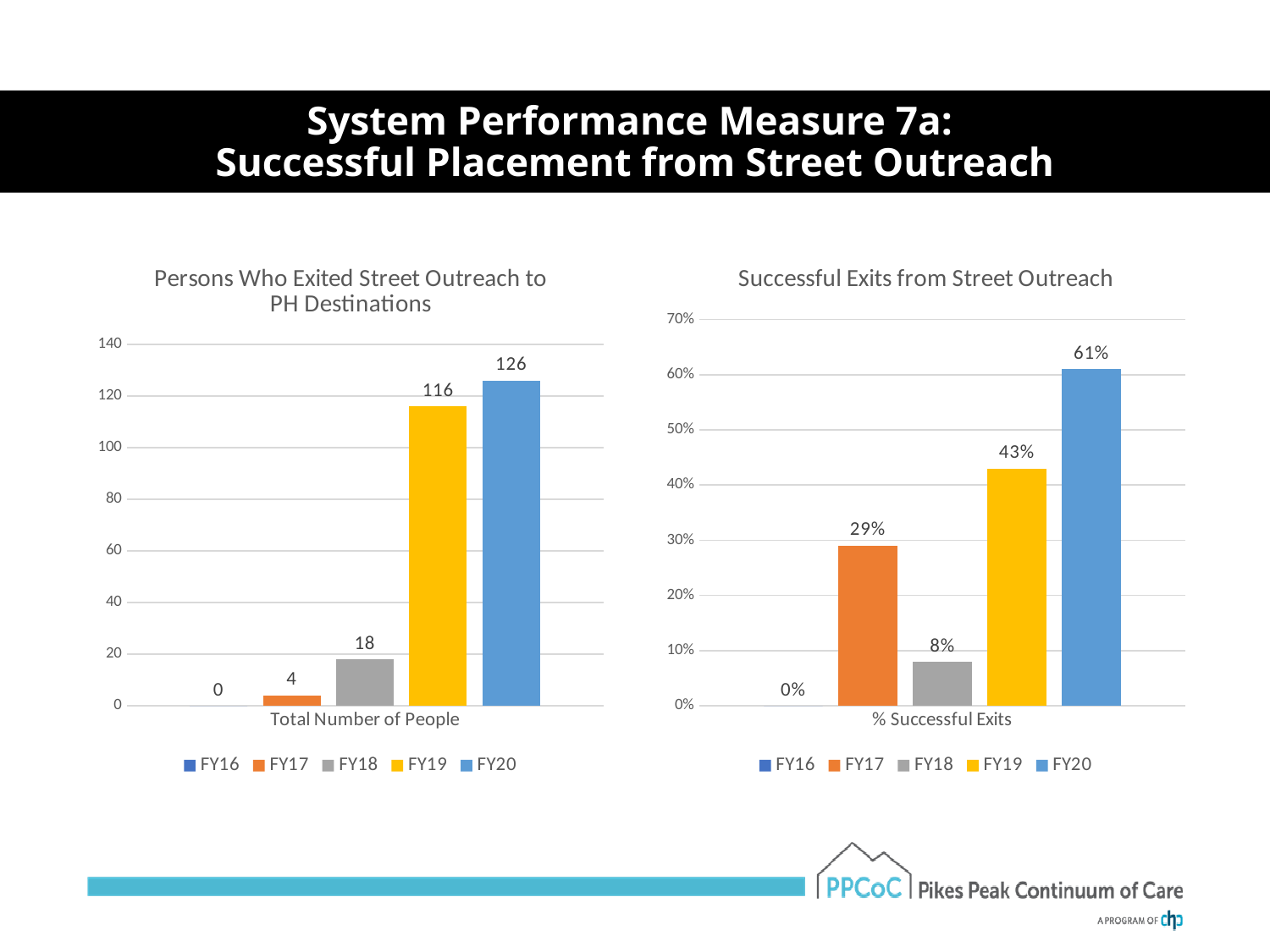
How many series does the legend of the 'Persons Who Exited Street Outreach to PH Destinations' chart list? 5 In the 'Successful Exits from Street Outreach' chart, what is the value for FY20? 61% In the 'Successful Exits from Street Outreach' chart, what is the value for FY17? 29% What kind of chart is the 'Successful Exits from Street Outreach' chart? Bar chart In the 'Persons Who Exited Street Outreach to PH Destinations' chart, what is the difference between the FY20 and FY19 values? 10 In the 'Successful Exits from Street Outreach' chart, which is larger, the value for FY17 or the value for FY18? FY17 In the 'Successful Exits from Street Outreach' chart, which fiscal year has the lowest value? FY16 In the 'Persons Who Exited Street Outreach to PH Destinations' chart, what is the value for FY18? 18 In the 'Successful Exits from Street Outreach' chart, what is the x-axis category label? % Successful Exits In the 'Persons Who Exited Street Outreach to PH Destinations' chart, which fiscal year has the highest value? FY20 In the 'Successful Exits from Street Outreach' chart, what is the difference between the FY19 and FY18 values? 35% In the 'Persons Who Exited Street Outreach to PH Destinations' chart, what is the value for FY19? 116